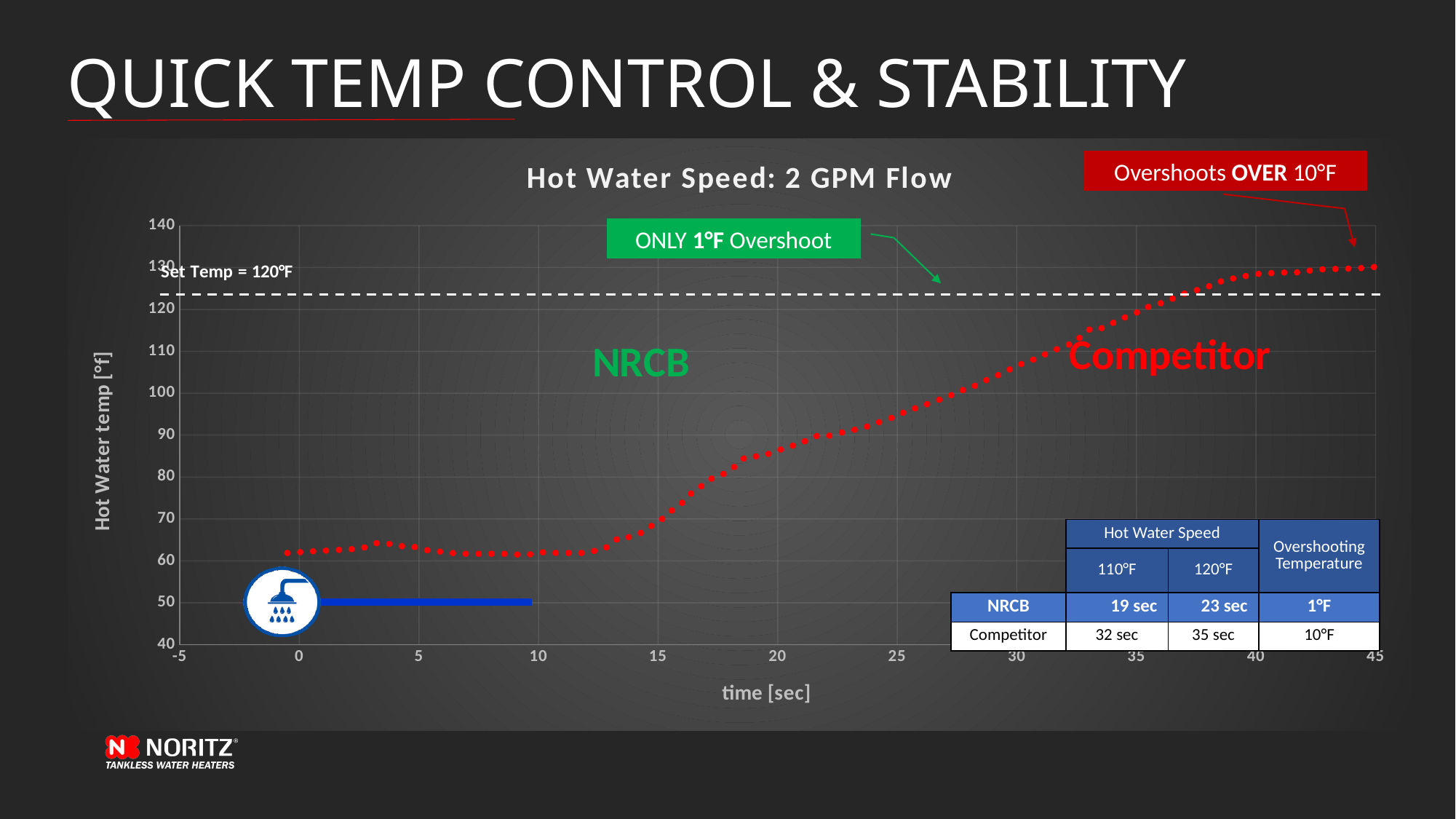
According to the table, how many seconds does the Competitor take to reach 110°F? 32 sec Is the Competitor's hot water temperature at 45 seconds greater or less than 120? greater What is the label of the chart's x axis? time [sec] What is the overshooting temperature of the Competitor shown in the table? 10°F What is the set temperature marked by the dashed line on the chart? 120°F What kind of chart is shown on the slide? Line chart How many seconds faster does the NRCB reach 120°F than the Competitor, according to the table? 12 sec What is the title of the chart? Hot Water Speed: 2 GPM Flow Does the Competitor's temperature line rise or fall between 15 and 40 seconds? rise Is the Competitor's hot water temperature at 10 seconds greater or less than 70? less Which has the larger overshooting temperature, NRCB or Competitor? Competitor According to the table, how many seconds does the NRCB take to reach 120°F? 23 sec